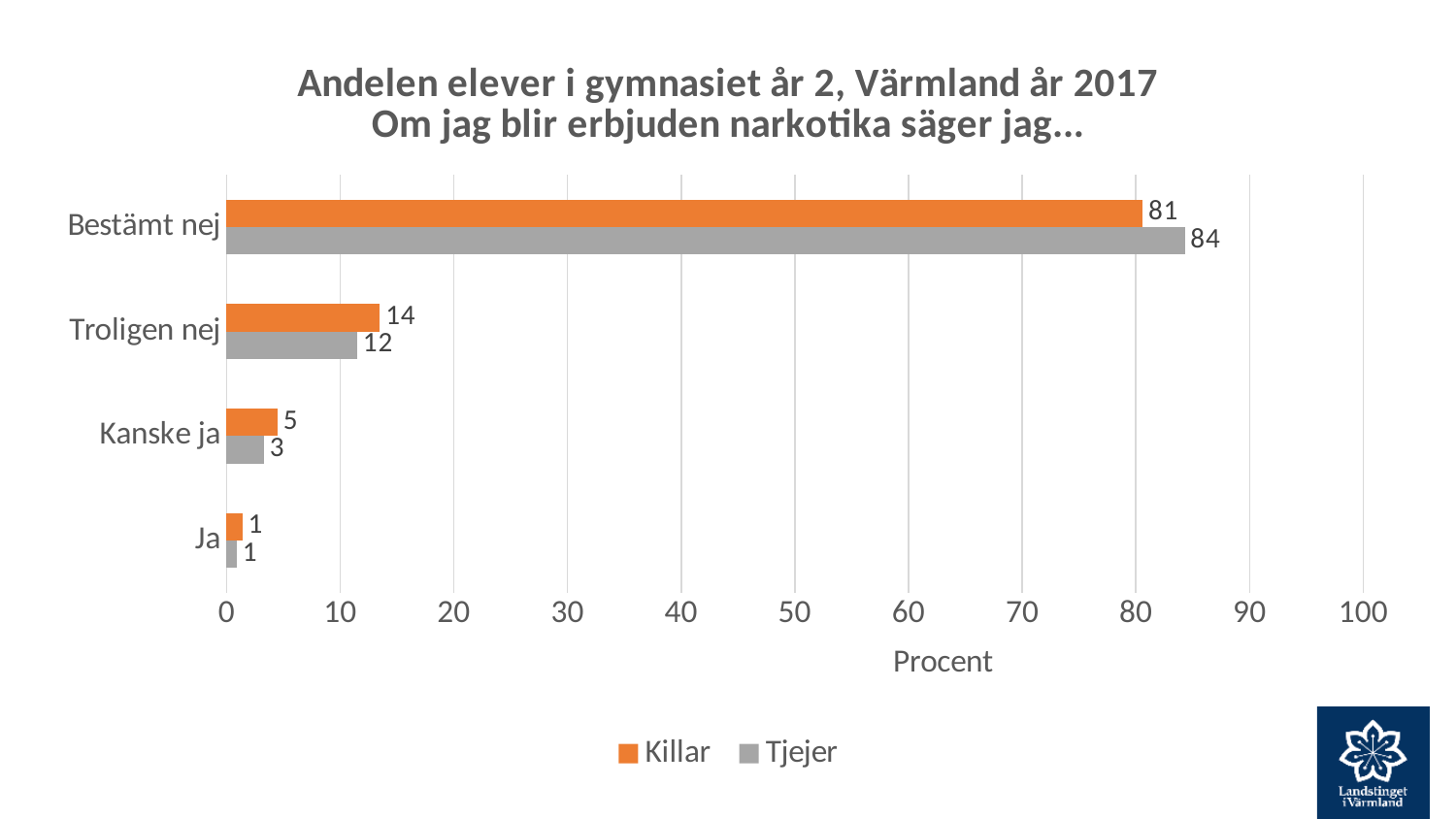
Which category has the lowest value for Killar? Ja Which is larger for Troligen nej, Killar or Tjejer? Killar Is the value for Tjejer in Bestämt nej greater or less than 80? greater What is the label of the horizontal axis? Procent What is the value for Killar in the Kanske ja category? 5 How many series does the legend list? 2 Which category has the highest value for Tjejer? Bestämt nej How many categories are shown on the chart? 4 What is the difference between the Tjejer and Killar values for Bestämt nej? 3 What kind of chart is shown on the slide? Bar chart What is the value for Tjejer in the Troligen nej category? 12 What is the value for Killar in the Bestämt nej category? 81